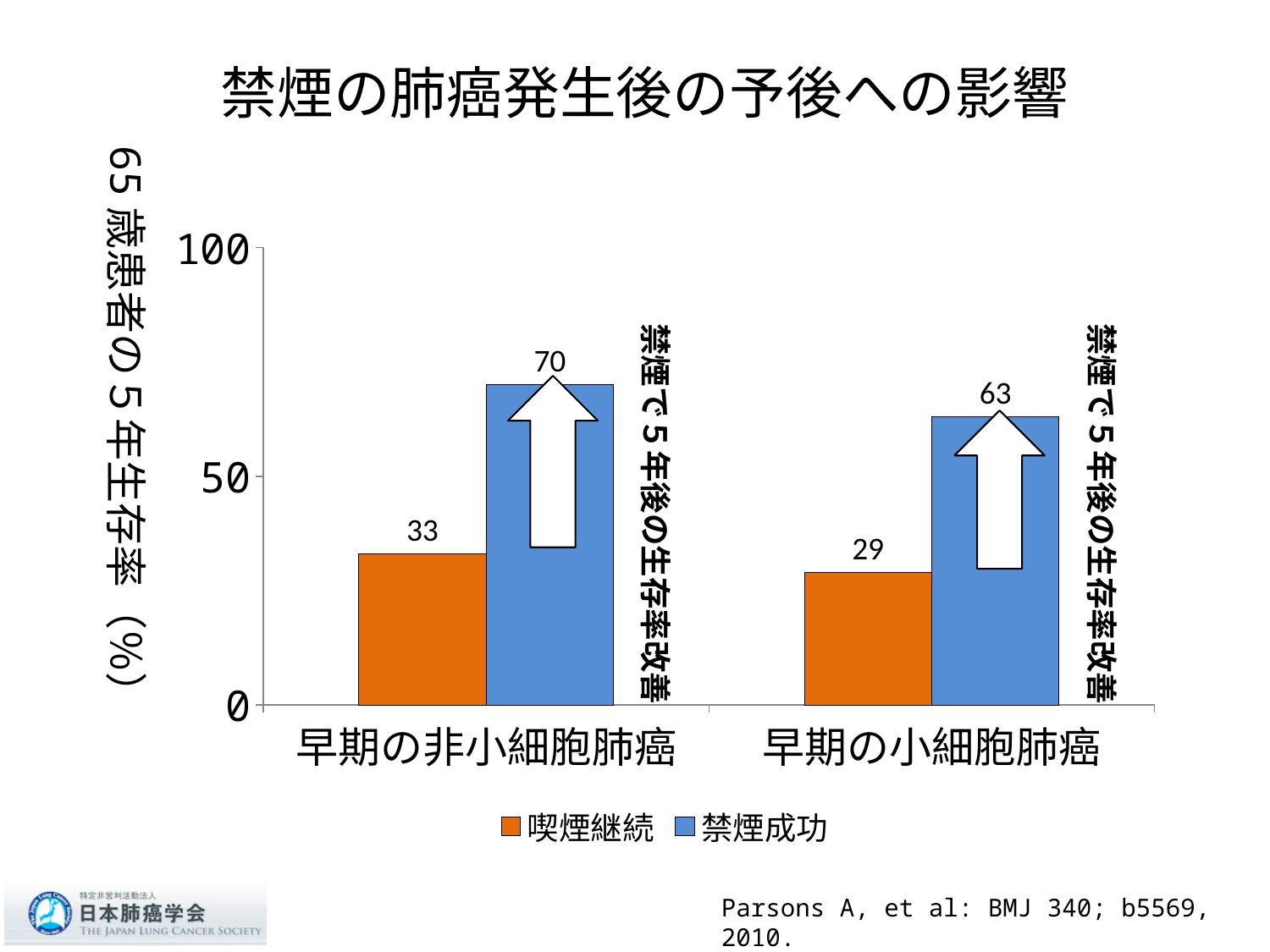
What is the 5-year survival rate for 喫煙継続 in 早期の非小細胞肺癌? 33 How many series does the legend list? 2 What is the 5-year survival rate for 禁煙成功 in 早期の非小細胞肺癌? 70 What is the difference between the 禁煙成功 and 喫煙継続 survival rates for 早期の小細胞肺癌? 34 Which bar shows the lowest 5-year survival rate? 喫煙継続 in 早期の小細胞肺癌 How many categories are shown on the x axis? 2 Which bar shows the highest 5-year survival rate? 禁煙成功 in 早期の非小細胞肺癌 What kind of chart is shown on the slide? Bar chart Which is larger: the 喫煙継続 value for 早期の非小細胞肺癌 or the 喫煙継続 value for 早期の小細胞肺癌? 早期の非小細胞肺癌 What is the 5-year survival rate for 禁煙成功 in 早期の小細胞肺癌? 63 What is the difference between the 禁煙成功 and 喫煙継続 survival rates for 早期の非小細胞肺癌? 37 What is the 5-year survival rate for 喫煙継続 in 早期の小細胞肺癌? 29